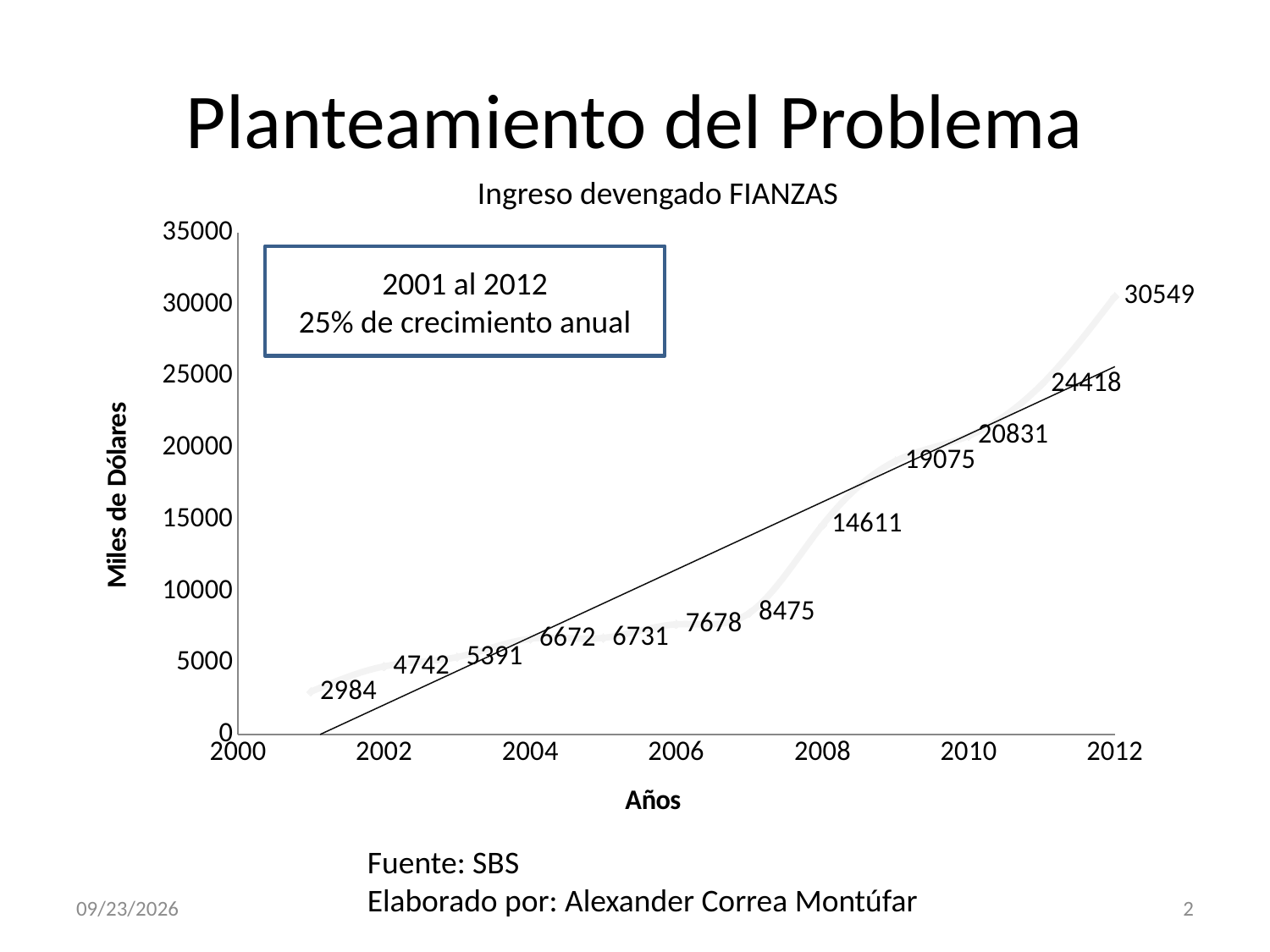
What is the difference between the values for 2012 and 2011 (30549 and 24418)? 6131 What type of chart is shown on the slide? line chart What is the lowest value plotted on the chart? 2984 What is the value for 2008? 14611 Which year has the larger value, 2008 or 2006? 2008 Do the values rise or fall from 2001 to 2012? rise How many data points are plotted on the chart? 12 What is the highest value plotted on the chart? 30549 What is the value for 2004? 6672 What is the value for 2012? 30549 What is the value for 2010? 20831 What is the title of the chart? Ingreso devengado FIANZAS